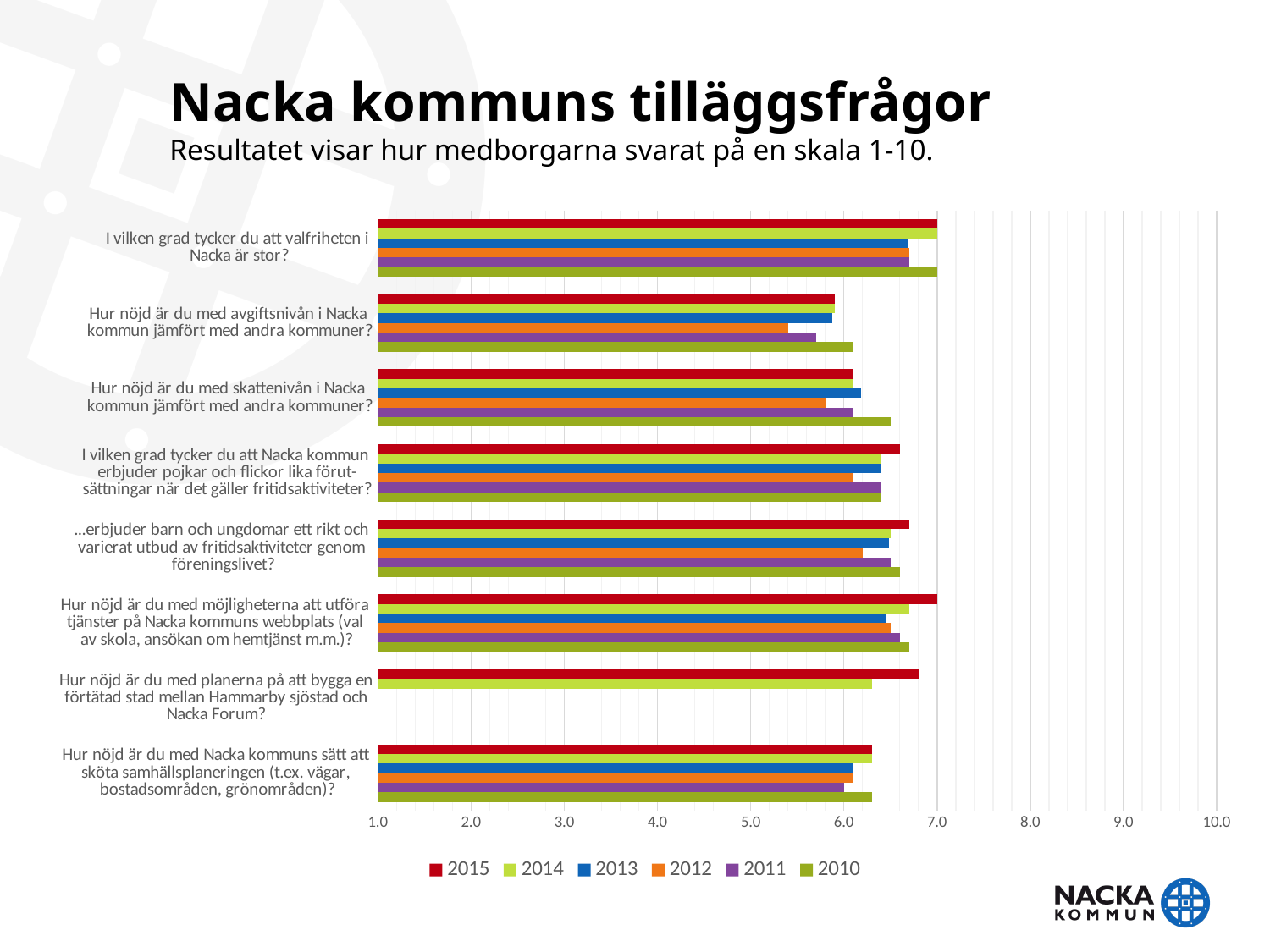
Is the 2012 value for "Hur nöjd är du med avgiftsnivån i Nacka kommun jämfört med andra kommuner?" greater or less than 6.0? less How many question categories are plotted on the chart? 8 What is the title of the slide? Nacka kommuns tilläggsfrågor How many series does the legend list? 6 Which years are listed in the legend? 2015, 2014, 2013, 2012, 2011, 2010 How many years have bars plotted for "Hur nöjd är du med planerna på att bygga en förtätad stad mellan Hammarby sjöstad och Nacka Forum?"? 2 For "Hur nöjd är du med planerna på att bygga en förtätad stad mellan Hammarby sjöstad och Nacka Forum?", which is larger, the 2015 value or the 2014 value? 2015 Is the 2011 value for "Hur nöjd är du med avgiftsnivån i Nacka kommun jämfört med andra kommuner?" greater or less than 6.0? less Is the 2015 value for "Hur nöjd är du med planerna på att bygga en förtätad stad mellan Hammarby sjöstad och Nacka Forum?" greater or less than 6.0? greater What kind of chart is shown on the slide? bar chart For 2015, which is larger: the value for "I vilken grad tycker du att valfriheten i Nacka är stor?" or the value for "Hur nöjd är du med avgiftsnivån i Nacka kommun jämfört med andra kommuner?"? I vilken grad tycker du att valfriheten i Nacka är stor?